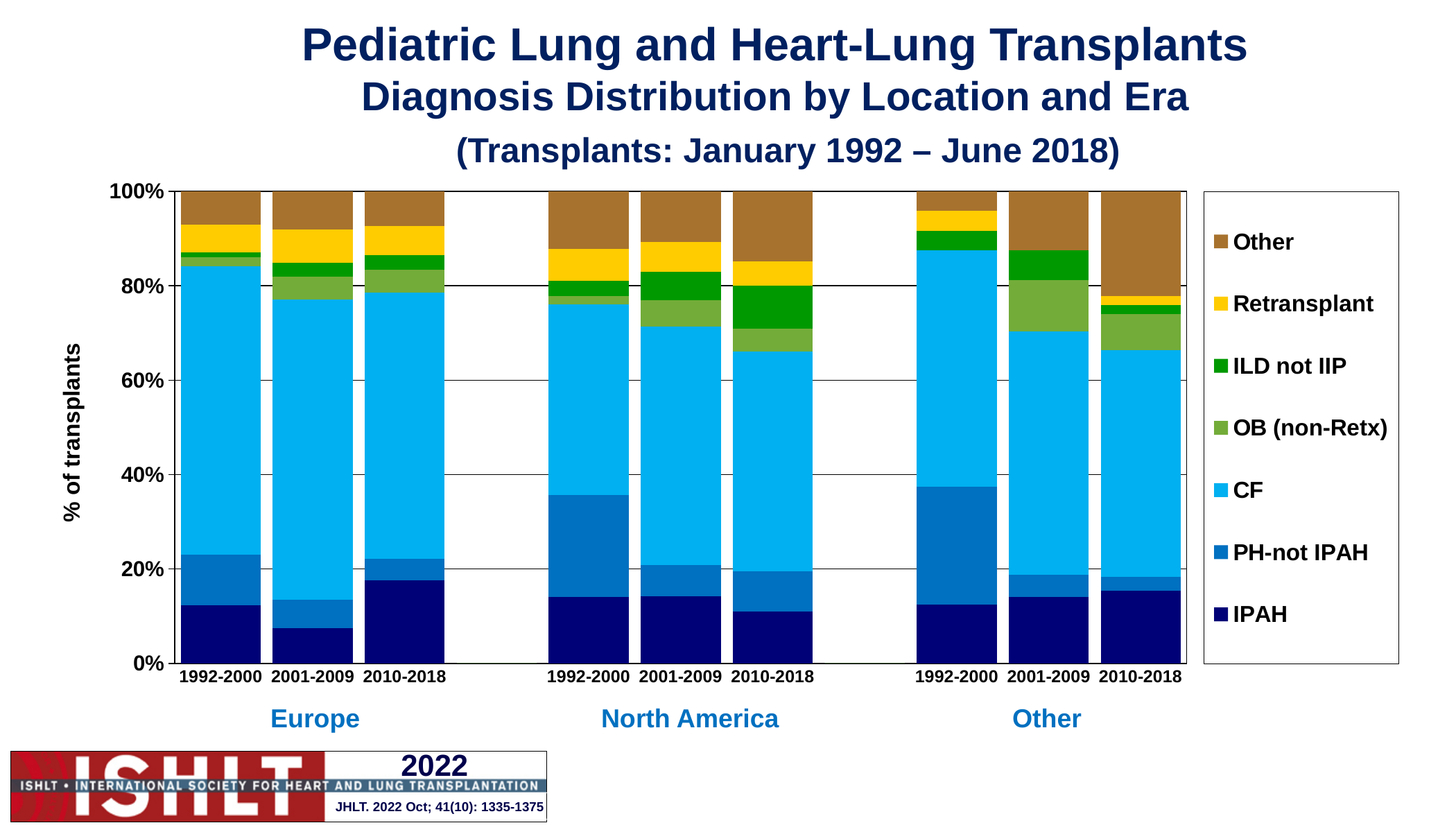
How many series does the legend list? 7 How many regions are shown along the x axis? 3 In the Other region, is the 'Other' diagnosis segment larger for 1992-2000 or for 2010-2018? 2010-2018 How many bars are plotted in the chart? 9 Which series is listed at the bottom of the legend? IPAH What is the label of the y axis? % of transplants What kind of chart is shown on the slide? Stacked bar chart Which era in Europe has the largest IPAH share? 2010-2018 Is the IPAH share for Europe 2001-2009 greater or less than 10%? less Is the IPAH share for Europe 2010-2018 greater or less than 20%? less Which era in Europe has the smallest IPAH share? 2001-2009